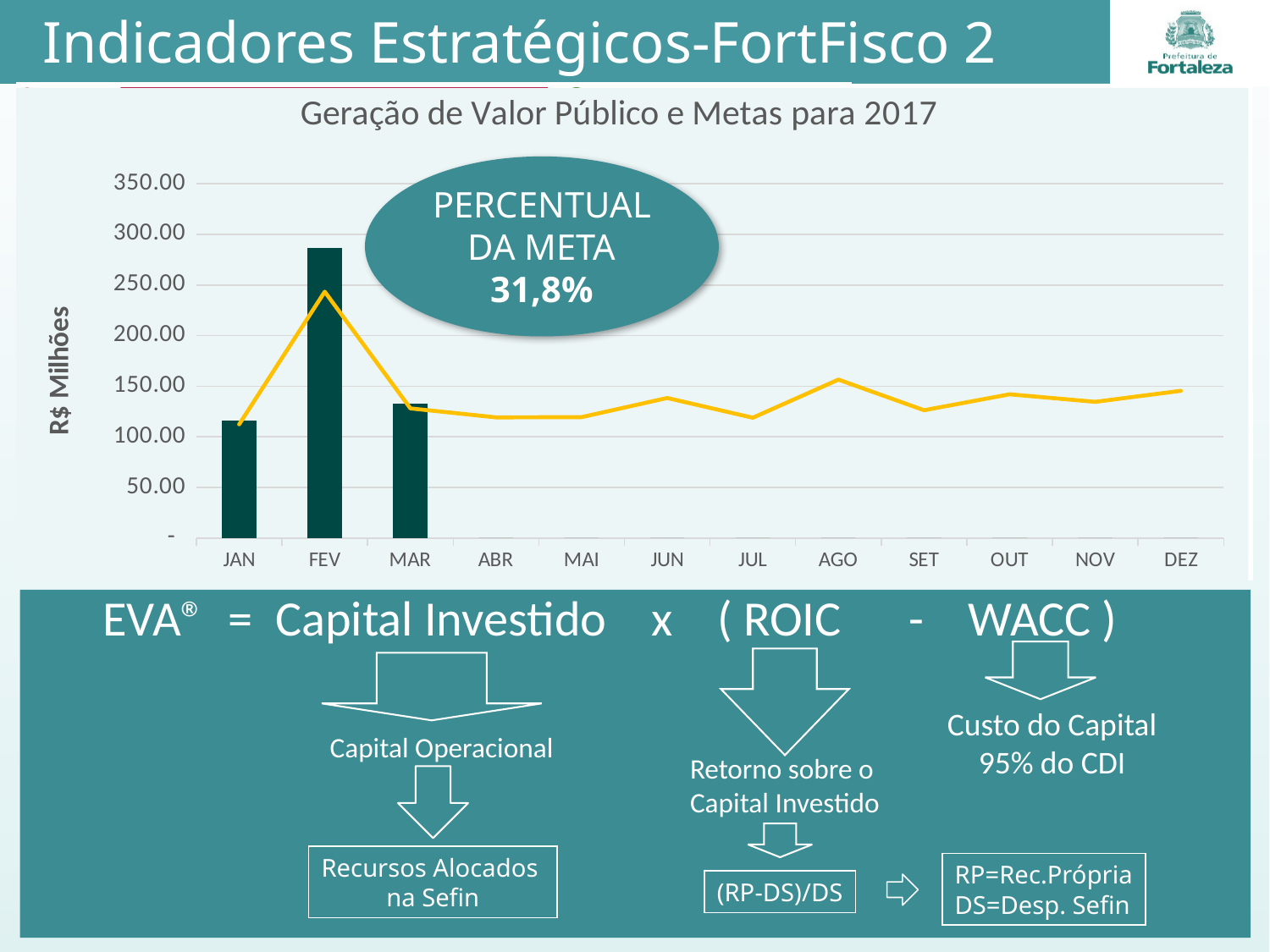
Is the bar value for MAR greater or less than 150? less What is the title of the chart? Geração de Valor Público e Metas para 2017 In which month does the line reach its highest point? FEV How many months are shown along the x axis of the chart? 12 Which month has the tallest bar in the chart? FEV What is the label on the vertical axis of the chart? R$ Milhões Which is larger, the bar for FEV or the bar for MAR? FEV Is the line value for AGO greater or less than 150? greater Is the bar value for FEV greater or less than 250? greater How many months have a bar plotted in the chart? 3 What kind of chart is shown on the slide? Combined bar and line chart Which month has the shortest bar in the chart? JAN